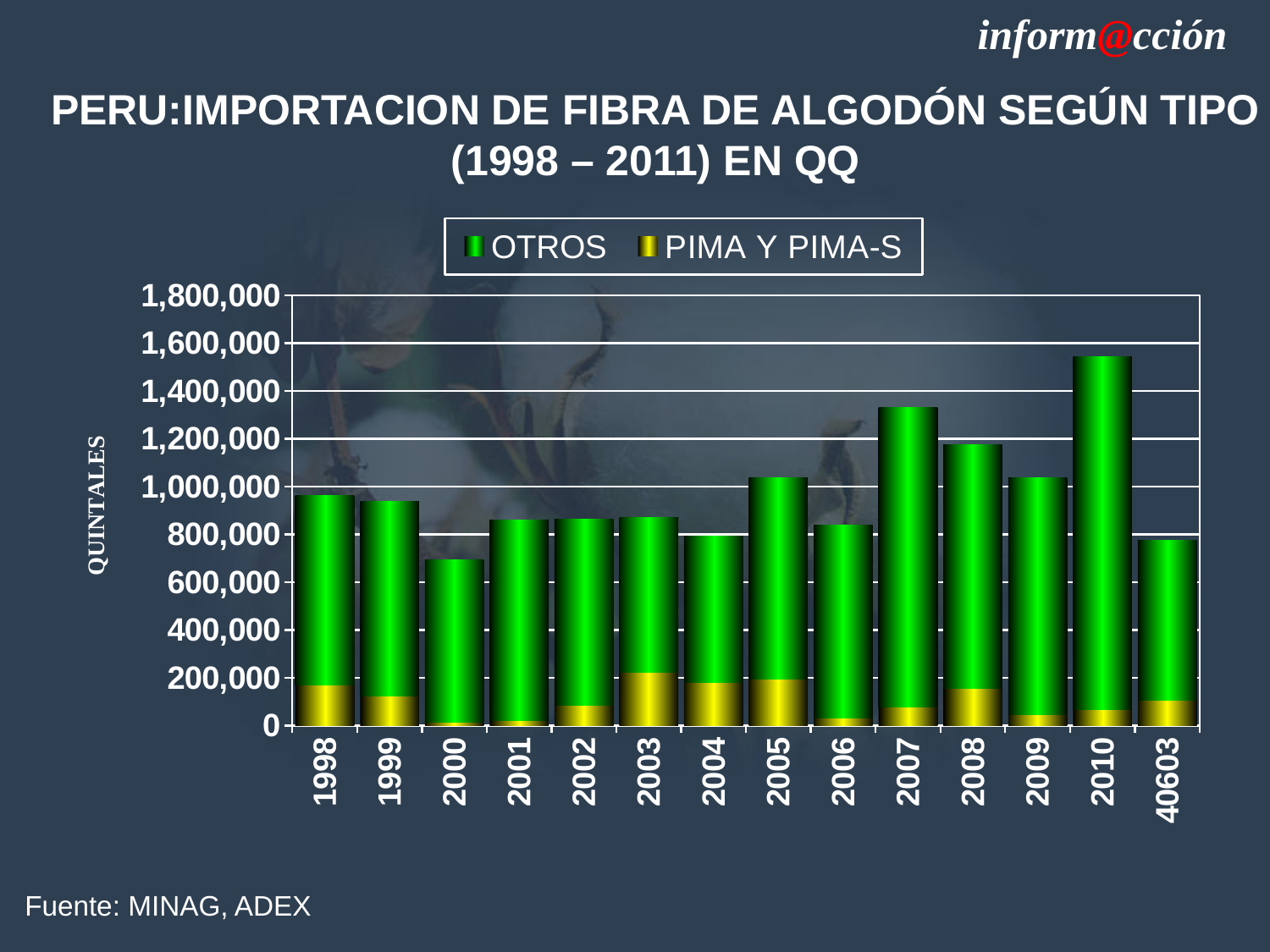
Which year has the highest total bar? 2010 Is the total value for 2000 greater or less than 800,000? less What are the two series named in the legend? OTROS and PIMA Y PIMA-S Is the total value for 2007 greater or less than 1,200,000? greater How many categories (years) are shown along the x axis? 14 What label is shown on the vertical axis? QUINTALES How many series does the legend list? 2 Is the total value for 2010 greater or less than 1,400,000? greater What kind of chart is shown on the slide? Stacked bar chart Which total bar is taller, 2007 or 2008? 2007 Which year has the lowest total bar? 2000